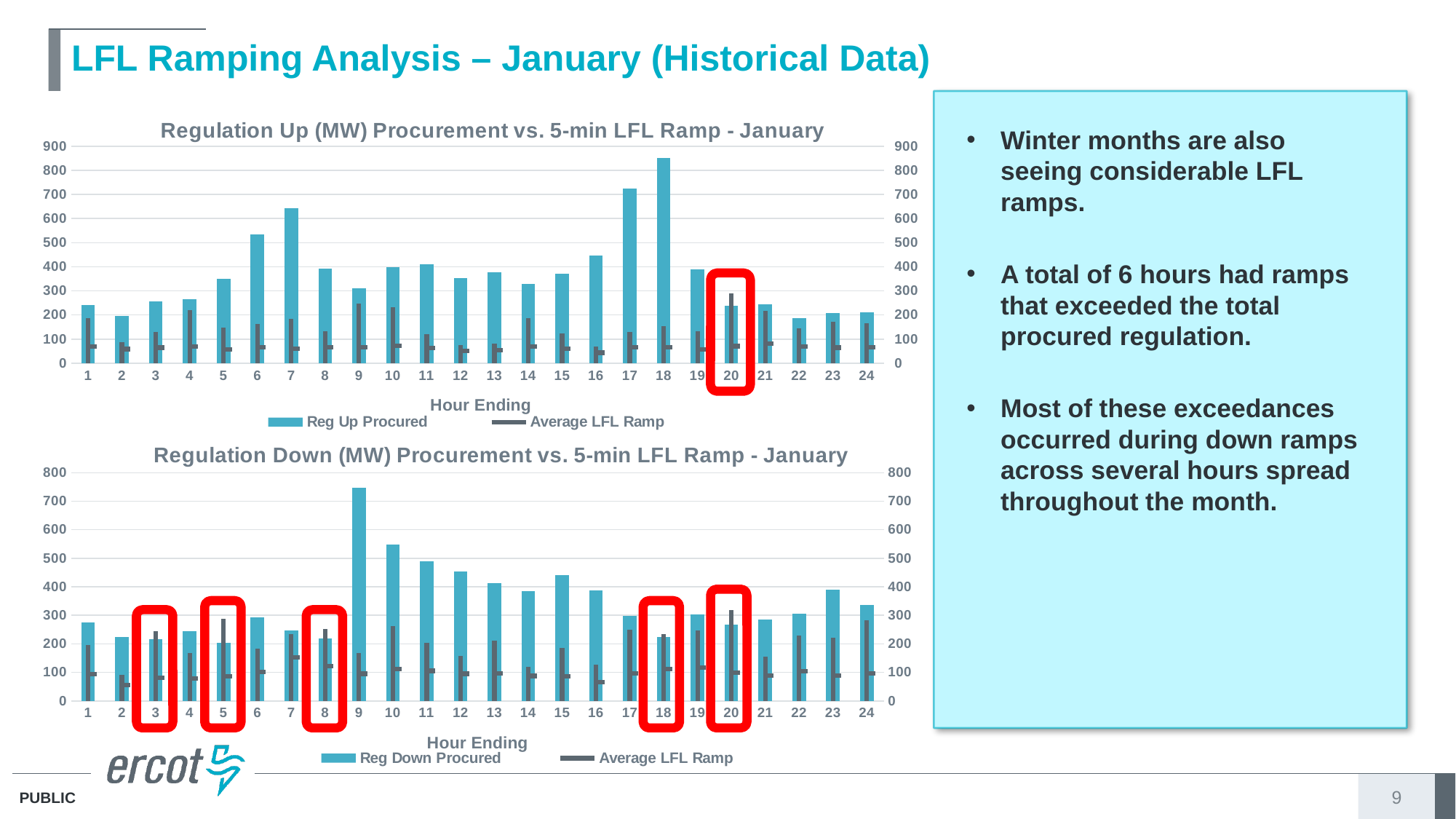
In the Regulation Down chart, which is larger, the Reg Down Procured value for hour ending 10 or for hour ending 13? Hour ending 10 How many hour-ending categories are shown on the x axis of the Regulation Down chart? 24 In the Regulation Up chart, is the Reg Up Procured value for hour ending 1 greater or less than 300? less In the Regulation Down chart, which hour ending has the highest Reg Down Procured value? 9 In the Regulation Up chart, is the Reg Up Procured value for hour ending 6 greater or less than 500? greater What type of chart is the Regulation Up (MW) Procurement vs. 5-min LFL Ramp - January chart? Bar chart In the Regulation Down chart, is the Reg Down Procured value for hour ending 5 greater or less than 300? less In the Regulation Up chart, which hour ending has the highest Reg Up Procured value? 18 In the Regulation Up chart, which is larger, the Reg Up Procured value for hour ending 17 or for hour ending 7? Hour ending 17 How many series does the legend of the Regulation Up chart list? 2